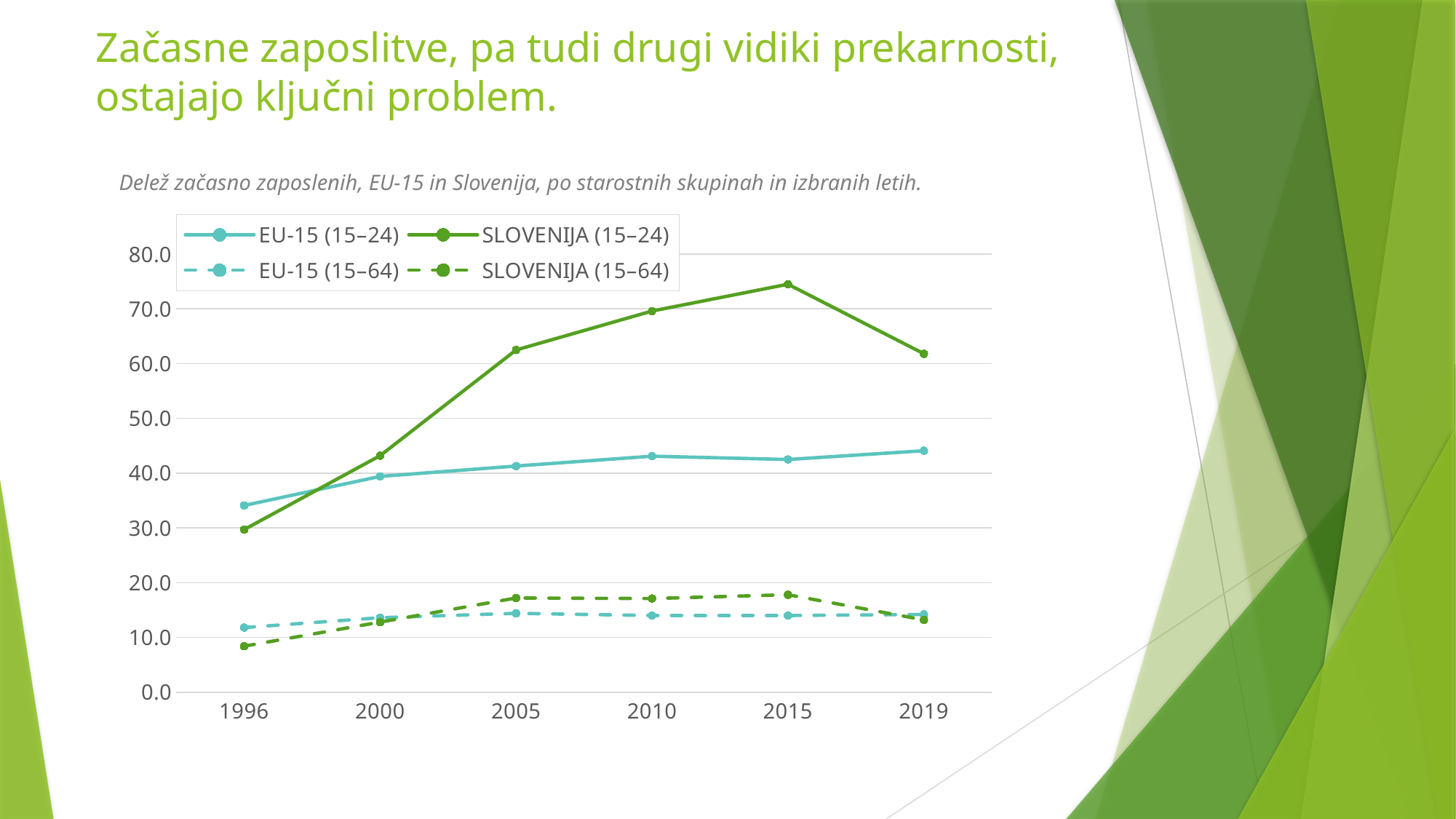
In 1996, which is larger: EU-15 (15–24) or SLOVENIJA (15–24)? EU-15 (15–24) What kind of chart is shown on the slide? line chart In which year does the SLOVENIJA (15–24) series reach its highest value? 2015 Does the SLOVENIJA (15–24) series rise or fall between 2015 and 2019? fall How many years are plotted along the x axis? 6 In 2010, which is larger: SLOVENIJA (15–24) or EU-15 (15–24)? SLOVENIJA (15–24) Is the value for SLOVENIJA (15–24) in 2015 greater or less than 70.0? greater In which year is the SLOVENIJA (15–64) series at its lowest? 1996 How many series does the legend list? 4 Which series is drawn with a solid dark green line? SLOVENIJA (15–24) Is the value for EU-15 (15–24) in 1996 greater or less than 30.0? greater Is the value for SLOVENIJA (15–64) in 1996 greater or less than 10.0? less